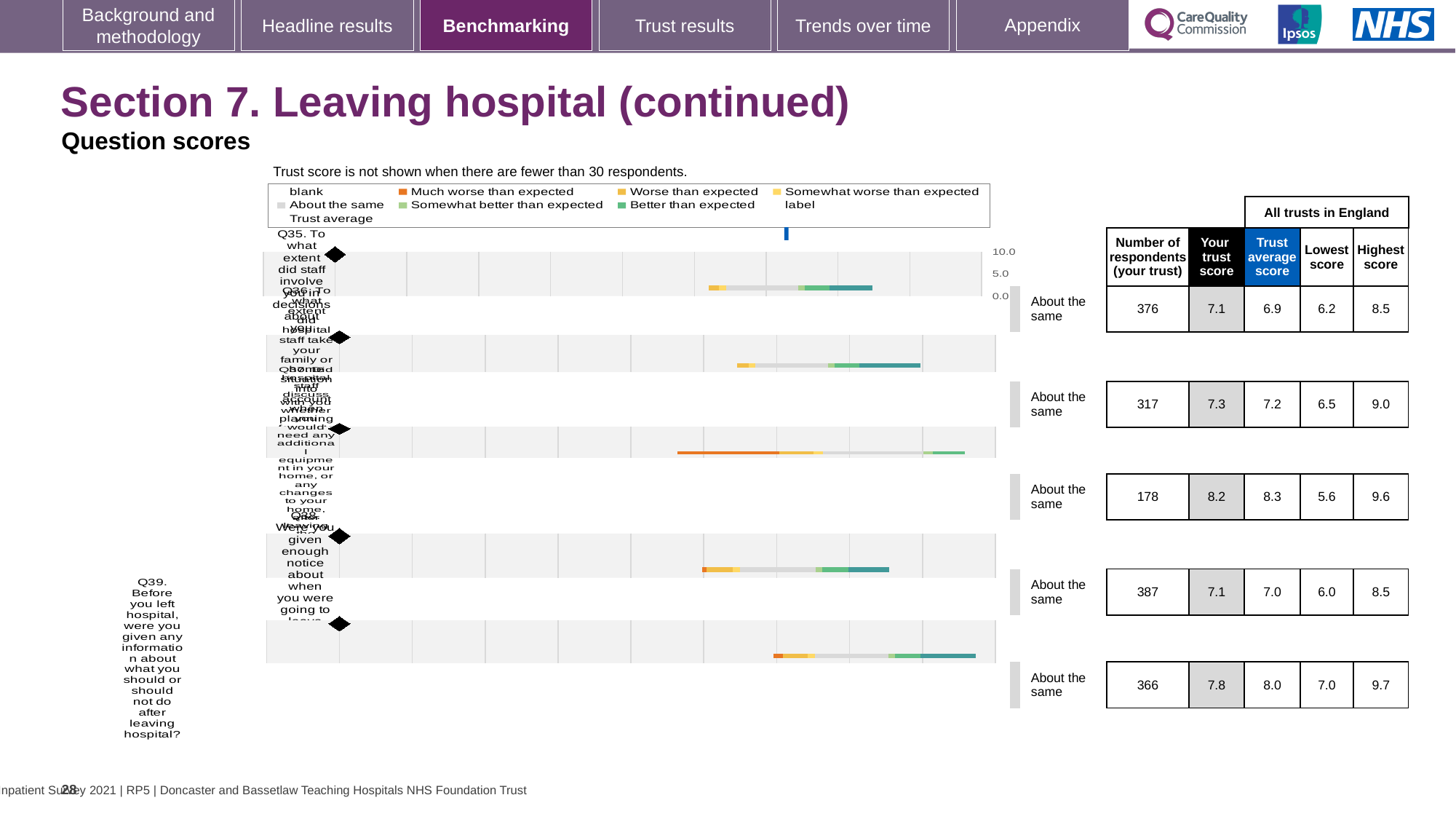
What is the lowest score across all trusts in England for Q38? 6.0 Which question has the lowest number of respondents? Q37 What benchmark category is shown next to the bar for Q35? About the same What is the 'Your trust score' for Q39 (information about what you should or should not do after leaving hospital)? 7.8 How many respondents does the table show for Q37? 178 What is the trust average score for Q35? 6.9 For Q39, what is the difference between the highest score and the lowest score across all trusts in England? 2.7 Which question has the highest 'Your trust score' in the table? Q37 How many questions (Q35 to Q39) are plotted in the chart? 5 For Q36, which is larger: the 'Your trust score' or the 'Trust average score'? Your trust score What kind of chart is used to show the question scores on this slide? Bar chart According to the note above the chart, when is the trust score not shown? When there are fewer than 30 respondents